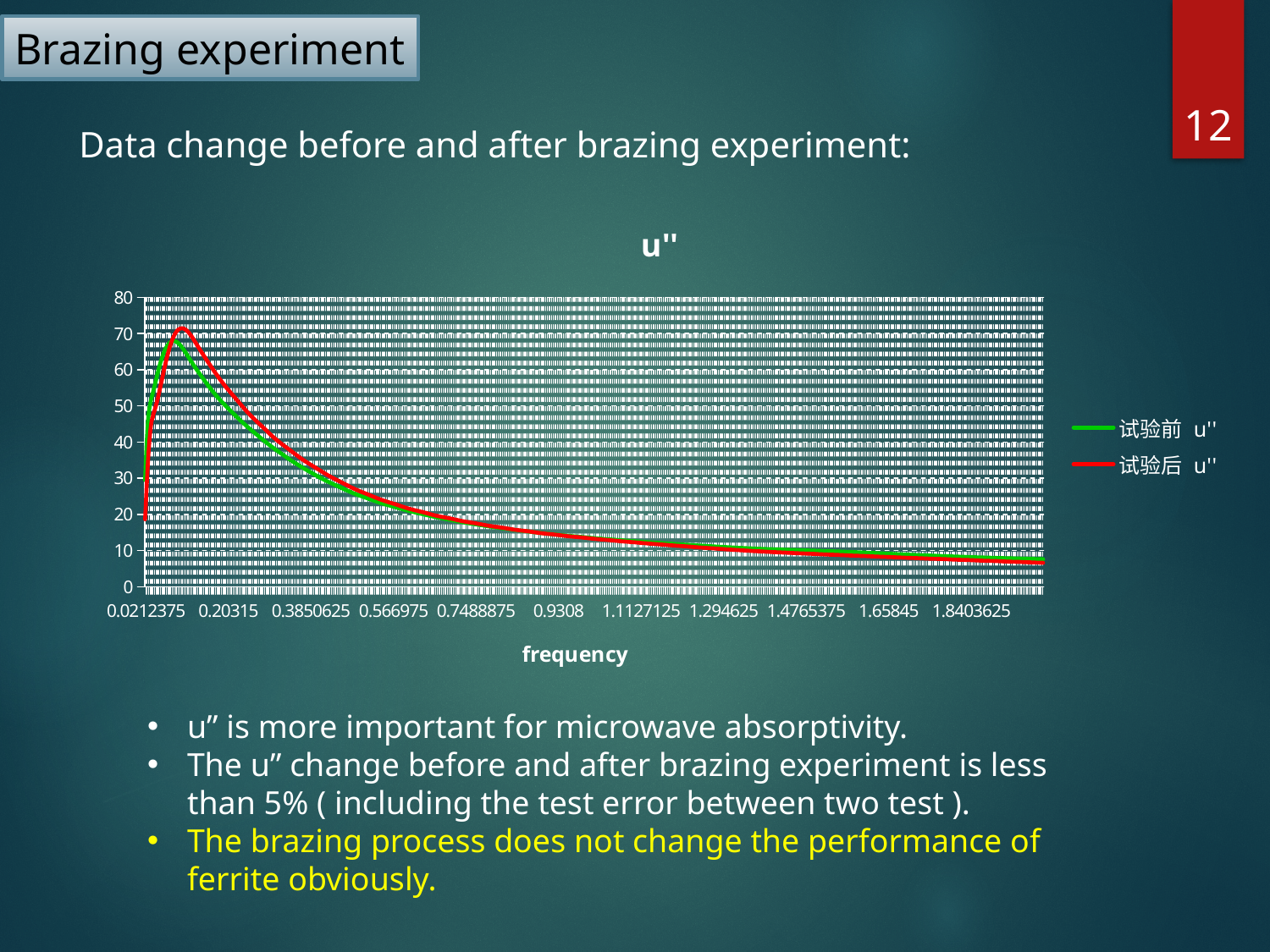
Is the value of the 试验前 u'' series at frequency 0.566975 greater or less than 30? less What is the highest value shown on the y axis? 80 Is the value of the 试验后 u'' series at frequency 1.8403625 greater or less than 10? less After the peak near the left of the chart, do the values rise or fall as frequency increases? fall What is the title of the chart? u'' At the peak, which series reaches the higher value, 试验前 u'' or 试验后 u''? 试验后 u'' What is the label of the x axis? frequency How many series does the legend list? 2 Is the value of the 试验前 u'' series at frequency 0.9308 greater or less than 20? less How many tick labels are shown along the x axis? 11 What kind of chart is shown on the slide? line chart